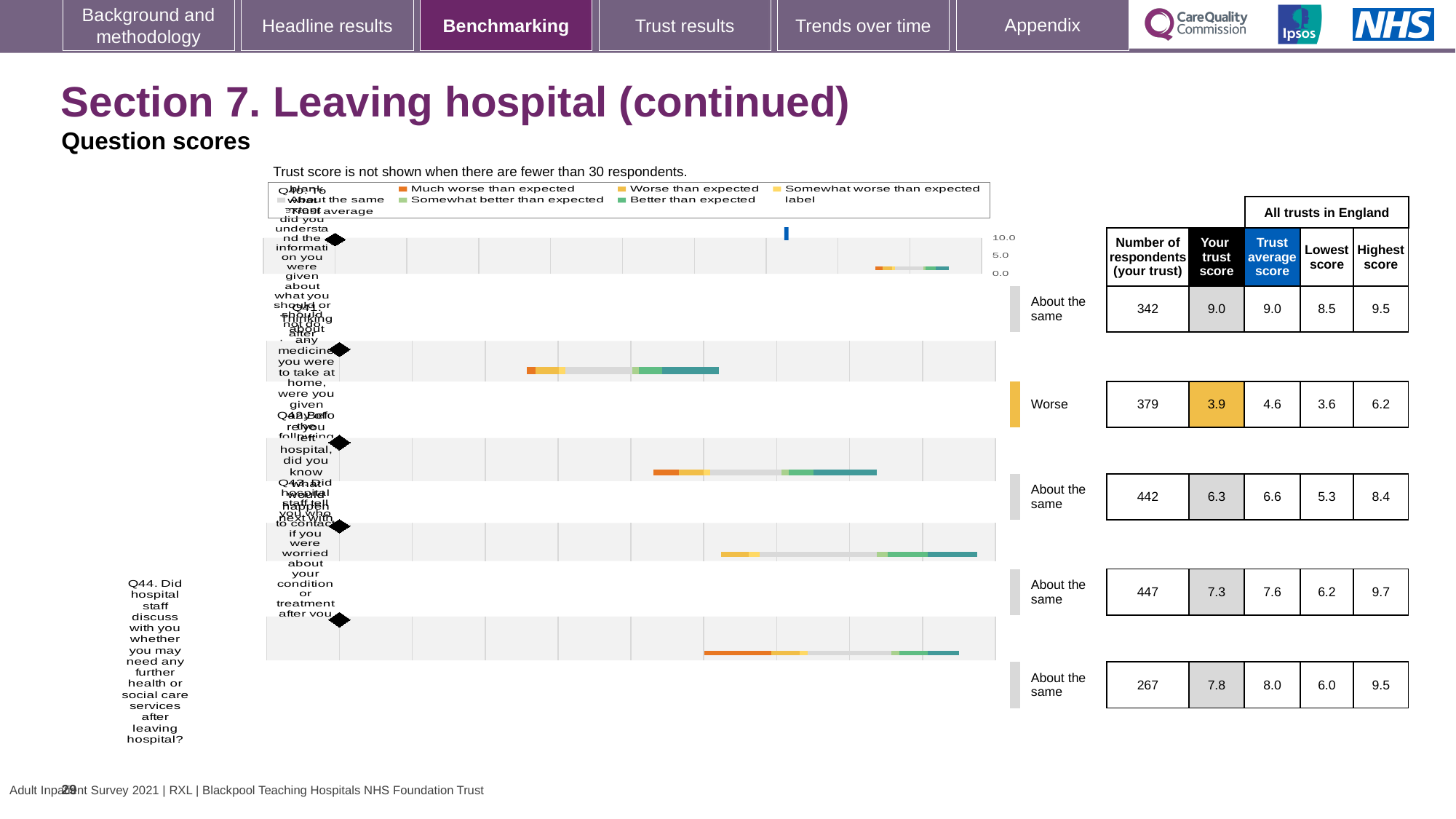
What is the trust's score for Q44? 7.8 What is the highest 'Your trust score' value shown in the table? 9.0 What is the highest score across all trusts in England for Q44? 9.5 Which is larger for Q44, the trust's own score or the trust average score? Trust average score What benchmark rating is given to the second question row, which has a trust score of 3.9? Worse What is the trust average score for Q44? 8.0 What is the difference between the trust average score and the trust's score for Q44? 0.2 What is the lowest score across all trusts in England for Q44? 6.0 What is the number of respondents for Q44 (discussing whether you may need further health or social care services after leaving hospital)? 267 What kind of chart is used to show the question scores on this slide? bar chart What is the lowest 'Your trust score' value shown in the table? 3.9 How many question rows are plotted in the benchmarking chart? 5